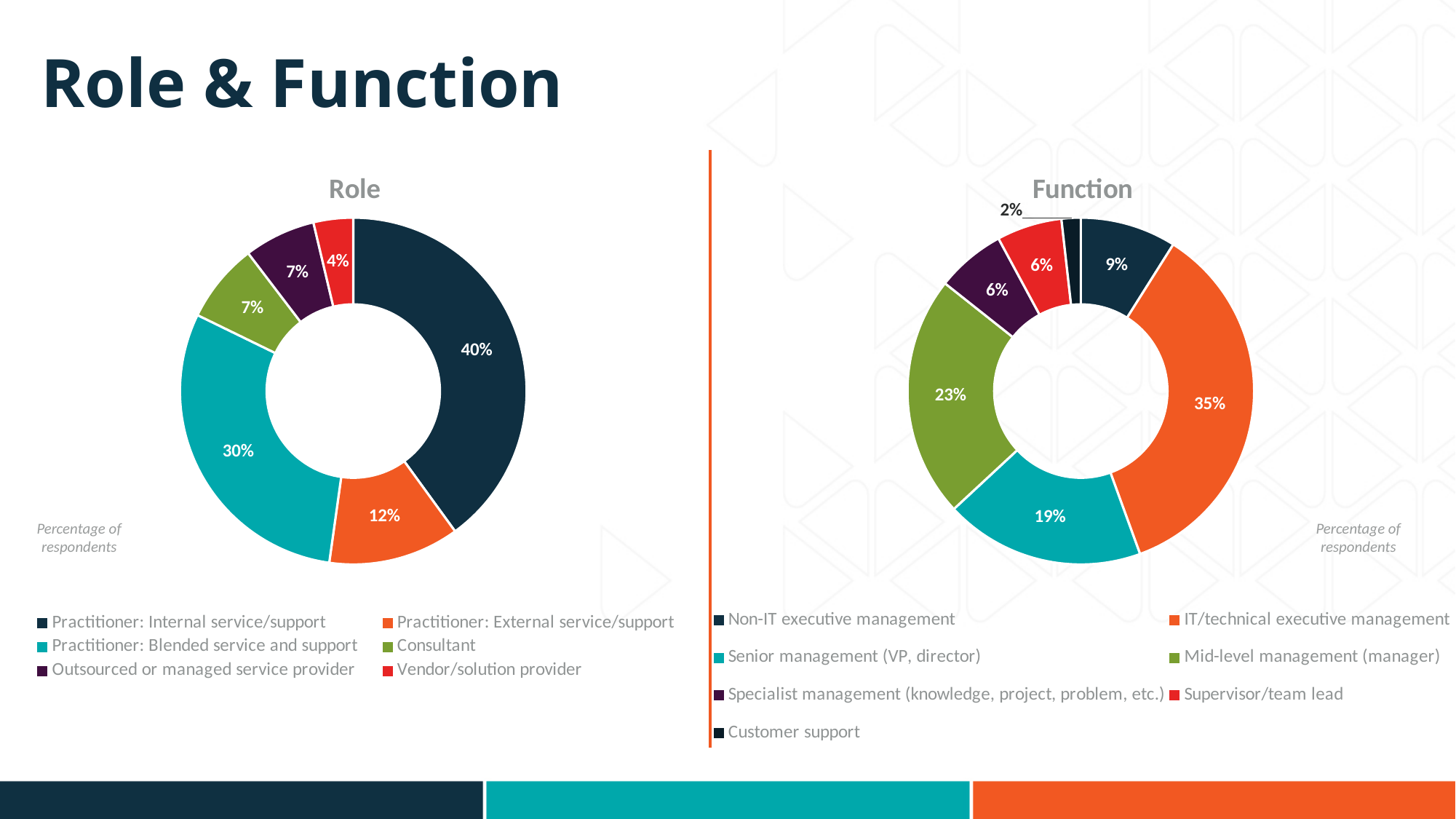
In the Role chart, which category has the smallest share? Vendor/solution provider In the Function chart, what percentage of respondents are Customer support? 2% What type of chart is the Role chart? Pie chart (doughnut) In the Role chart, what is the difference between the Practitioner: Internal service/support share and the Practitioner: External service/support share? 28% In the Function chart, what percentage of respondents are IT/technical executive management? 35% In the Function chart, which is larger: Mid-level management (manager) or Senior management (VP, director)? Mid-level management (manager) In the Function chart, which category has the largest share? IT/technical executive management In the Function chart, how many categories does the legend list? 7 In the Role chart, how many categories are shown? 6 In the Role chart, what percentage of respondents are Practitioner: Internal service/support? 40% In the Role chart, what percentage of respondents are Practitioner: Blended service and support? 30% In the Role chart, which category has the largest share? Practitioner: Internal service/support